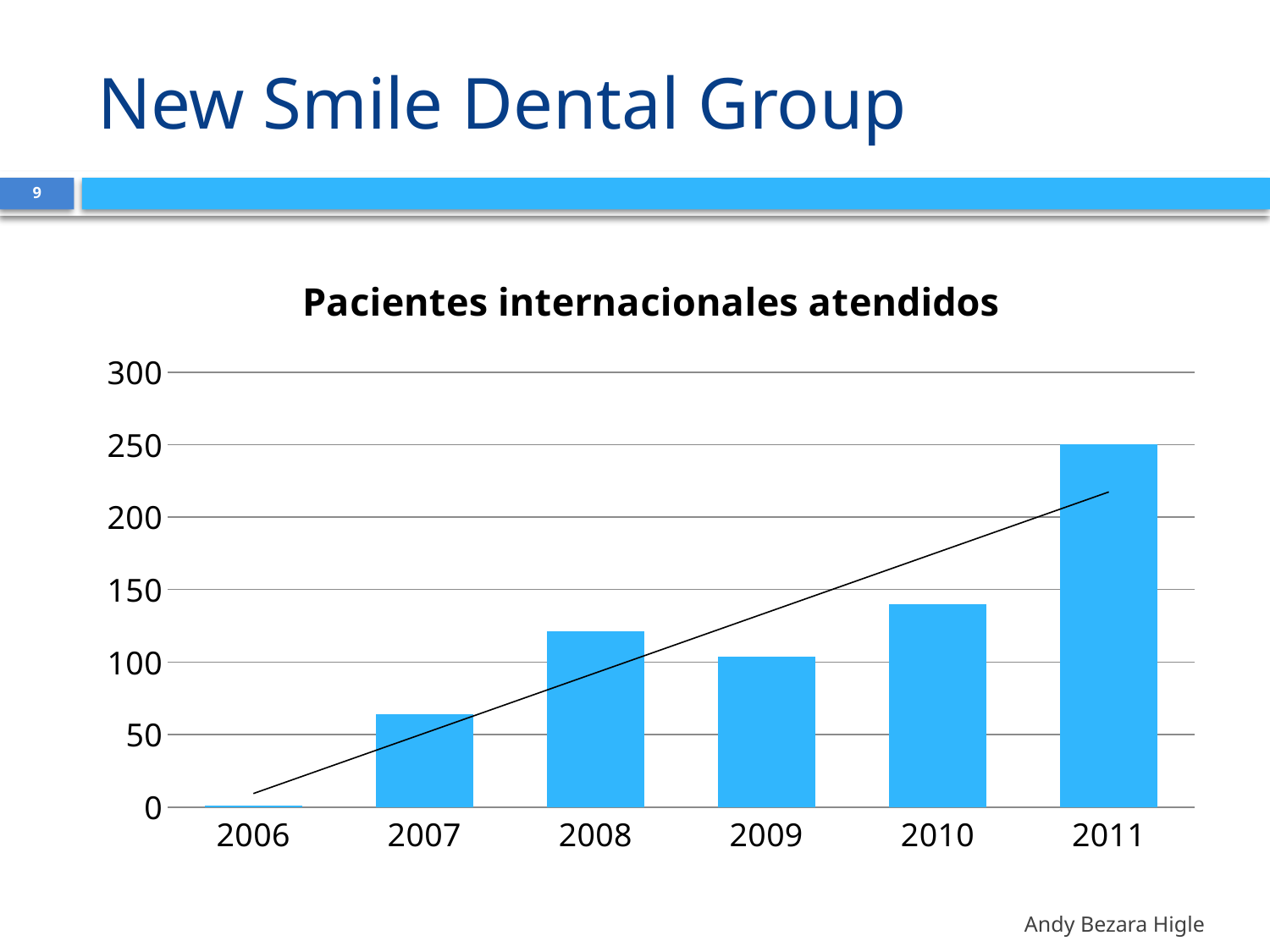
How many years are shown on the x axis of the chart? 6 Which year has the highest number of international patients attended? 2011 Is the value for 2007 greater or less than 100? less What is the title of the chart? Pacientes internacionales atendidos Do the values generally rise or fall from 2006 to 2011? rise What type of chart is shown on the slide? bar chart Is the value for 2006 greater or less than 50? less What is the value for 2011? 250 Which year has a larger value, 2008 or 2009? 2008 Which year has the lowest number of international patients attended? 2006 Is the value for 2008 greater or less than 100? greater